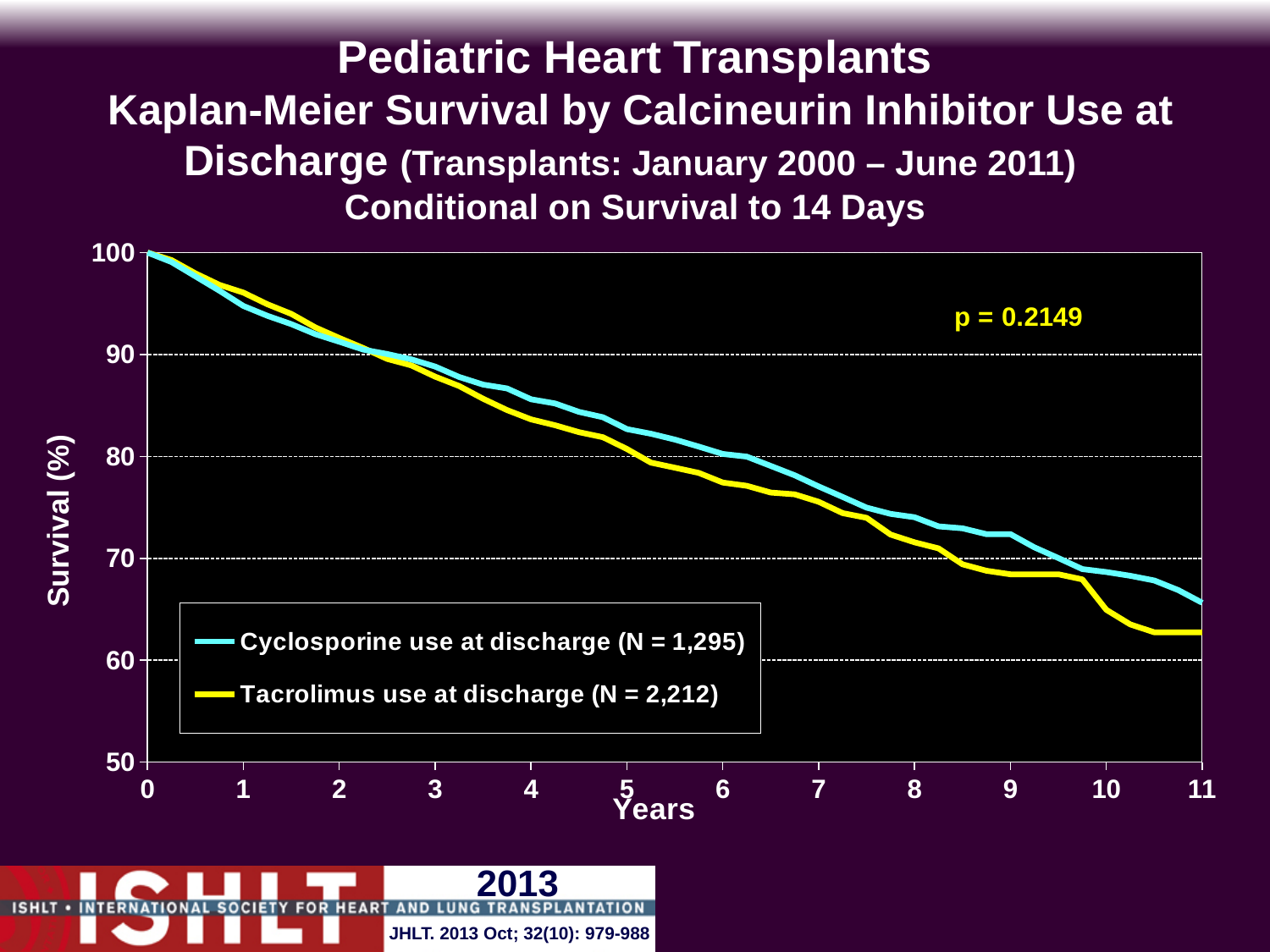
How many series does the legend list? 2 Is the survival value for Cyclosporine use at discharge at year 5 greater or less than 80? greater Do the survival curves rise or fall as years increase? fall Is the survival value for Cyclosporine use at discharge at year 11 greater or less than 60? greater At year 11, which series has the higher survival, Cyclosporine use at discharge or Tacrolimus use at discharge? Cyclosporine use at discharge What is the N for Tacrolimus use at discharge shown in the legend? N = 2,212 Is the survival value for Tacrolimus use at discharge at year 10 greater or less than 70? less What p-value is printed on the chart? p = 0.2149 At year 6, which series has the higher survival, Cyclosporine use at discharge or Tacrolimus use at discharge? Cyclosporine use at discharge What kind of chart is shown on the slide? line chart